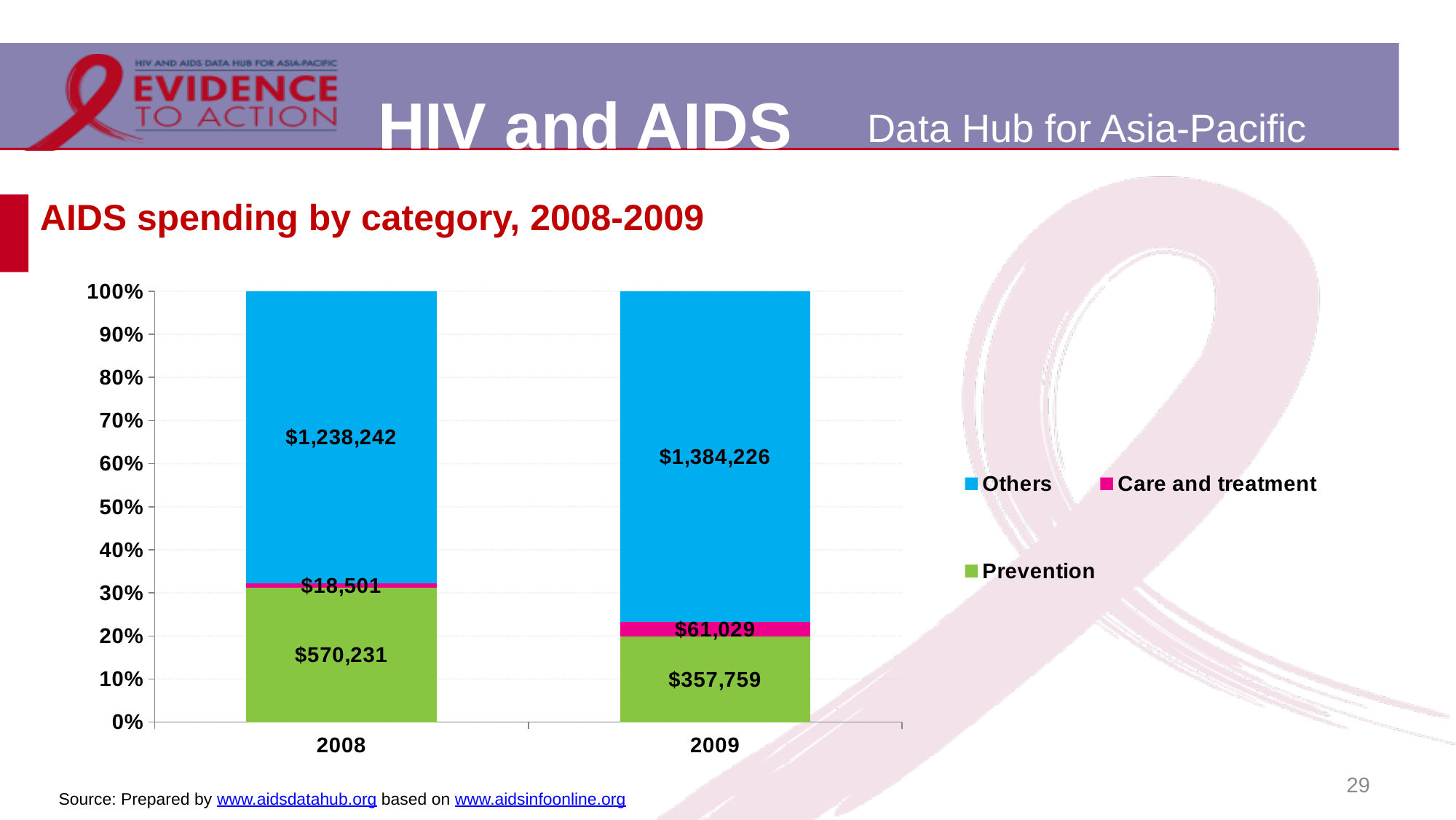
Was Prevention spending higher in 2008 or in 2009? 2008 What was the spending on Care and treatment in 2009? $61,029 How many years are shown on the x axis? 2 What kind of chart is shown on the slide? Stacked bar chart By how much did spending on Others increase from 2008 to 2009? $145,984 What is the total AIDS spending across all three categories in 2008? $1,826,974 What was the spending on Others in 2009? $1,384,226 What was the spending on Prevention in 2008? $570,231 How many series does the legend list? 3 Which category had the highest spending in 2009? Others What is the title of the chart? AIDS spending by category, 2008-2009 Which category had the lowest spending in 2008? Care and treatment